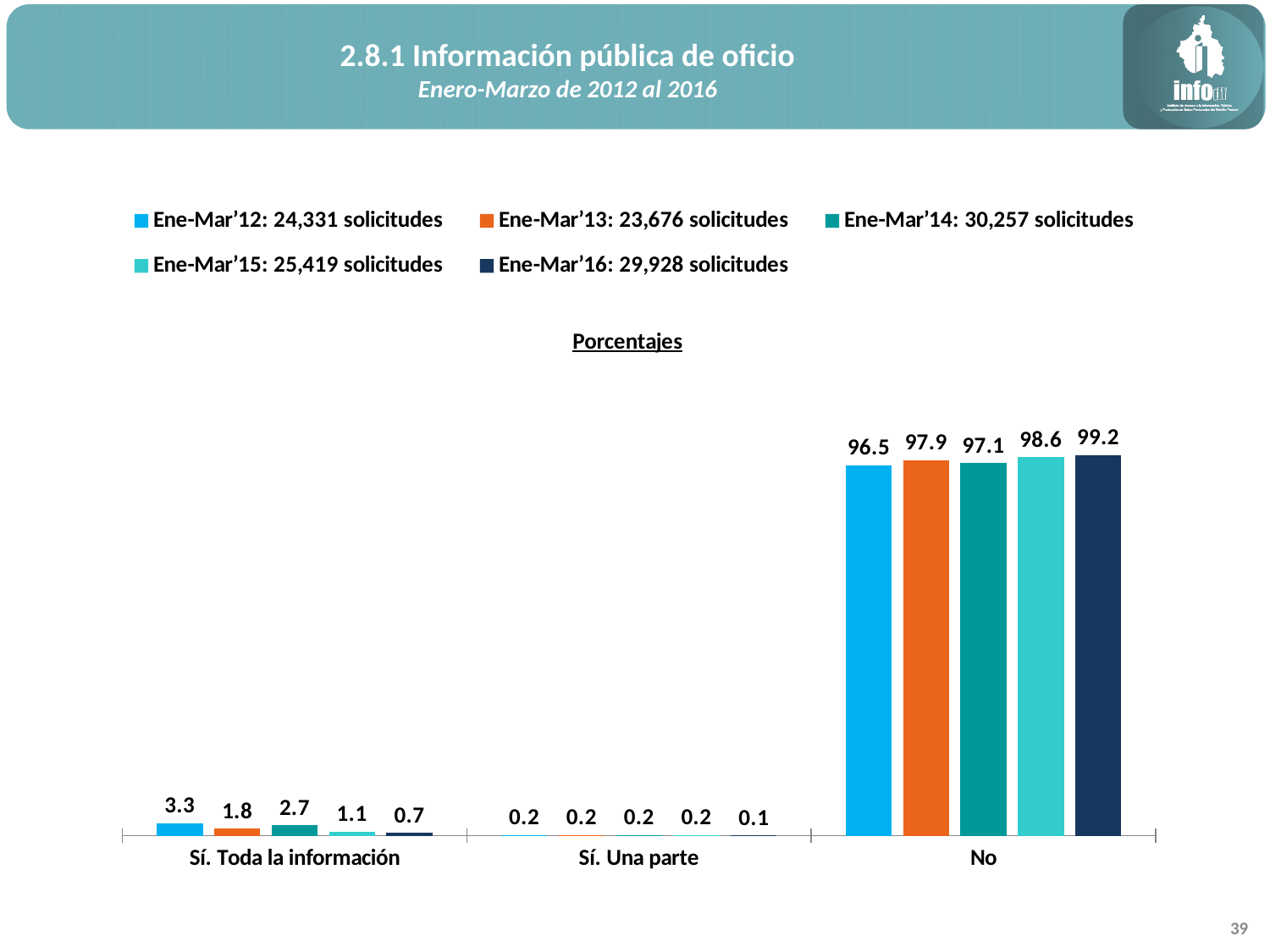
Which series has the lowest value for "Sí. Toda la información"? Ene-Mar'16: 29,928 solicitudes How many series does the legend list? 5 How many categories are shown on the x axis? 3 Which series has the highest value for "No"? Ene-Mar'16: 29,928 solicitudes What is the value for "Sí. Una parte" in the Ene-Mar'16 series? 0.1 What is the difference between the Ene-Mar'16 and Ene-Mar'12 values for "No"? 2.7 What kind of chart is shown on the slide? Bar chart What is the value for "No" in the Ene-Mar'16 series? 99.2 Which is larger for "Sí. Toda la información": the Ene-Mar'13 value or the Ene-Mar'14 value? Ene-Mar'14 What is the label shown above the chart? Porcentajes How many solicitudes does the legend give for Ene-Mar'14? 30,257 What is the value for "Sí. Toda la información" in the Ene-Mar'12 series? 3.3